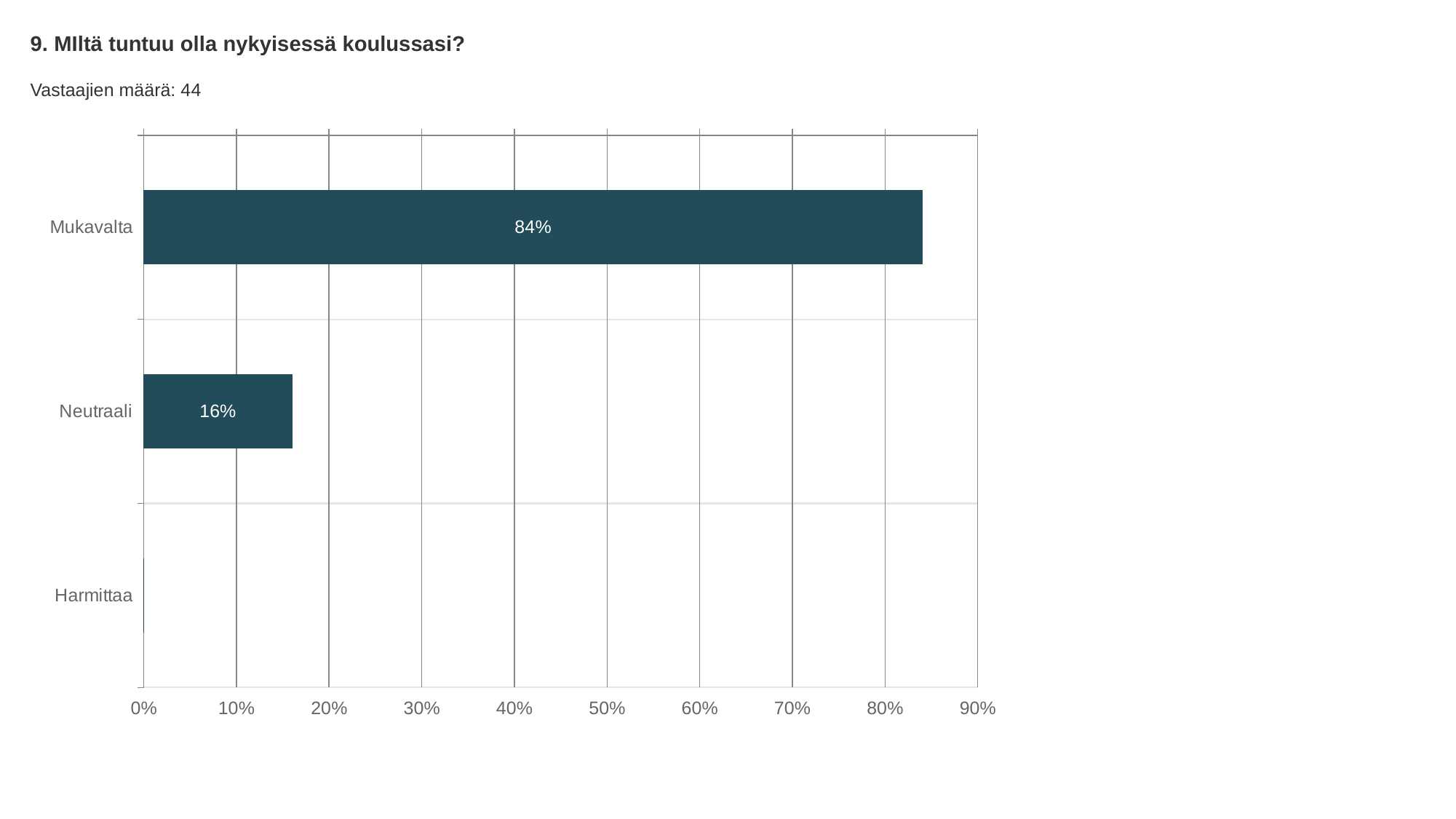
What is the value for Mukavalta? 84% What kind of chart is shown on the slide? bar chart Is the value for Neutraali greater or less than 20%? less Which category has the highest value? Mukavalta How many respondents (Vastaajien määrä) are reported on the slide? 44 Which category has the lowest value? Harmittaa What is the difference between the values for Mukavalta and Neutraali? 68% Is the value for Mukavalta greater or less than 80%? greater What is the title of the chart? 9. MIltä tuntuu olla nykyisessä koulussasi? How many categories are shown on the chart? 3 What is the value for Neutraali? 16% Which is larger, the value for Mukavalta or the value for Neutraali? Mukavalta